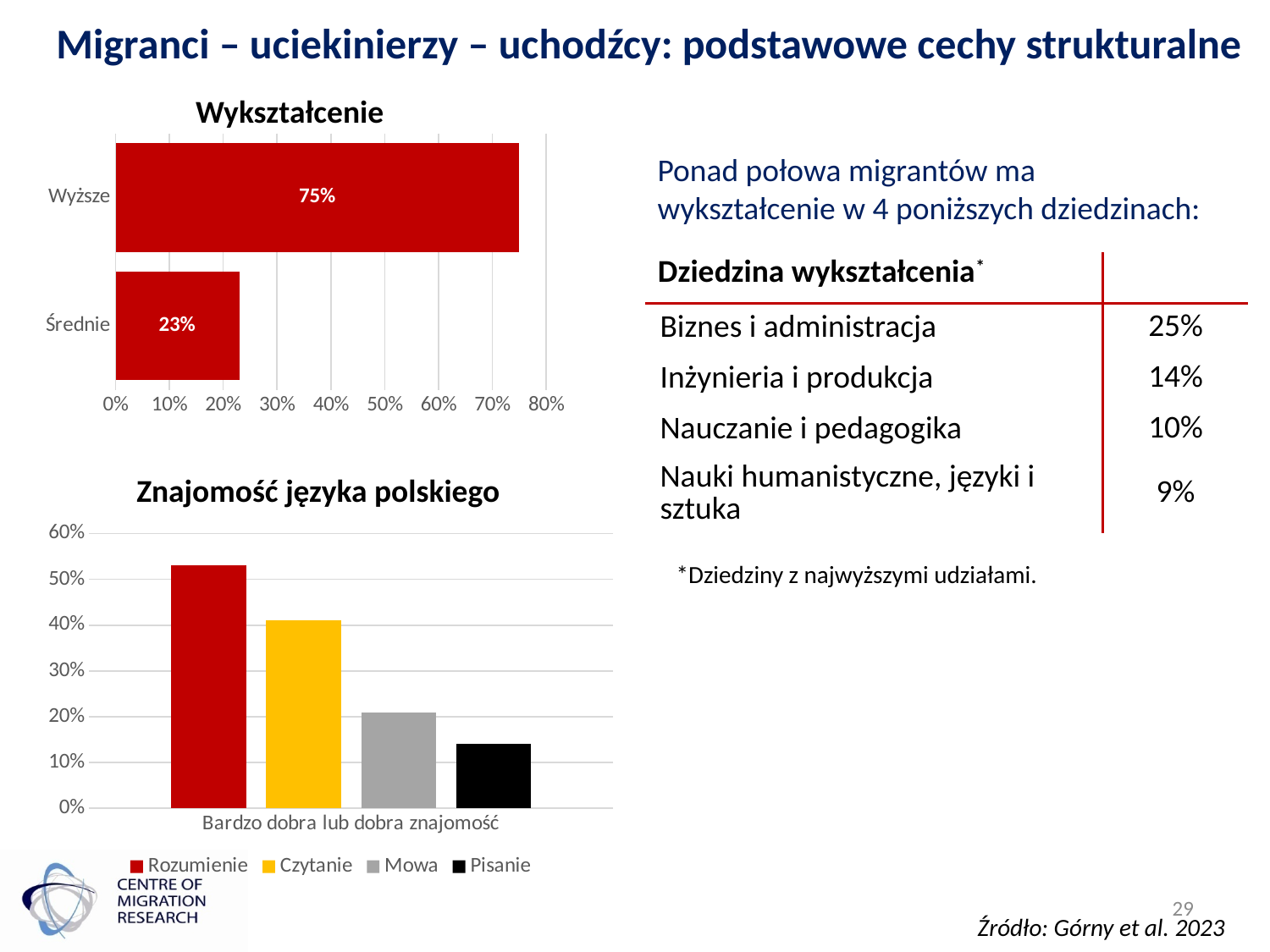
In the 'Znajomość języka polskiego' chart, which series is shown in yellow? Czytanie What kind of chart is the 'Wykształcenie' chart? Bar chart In the 'Znajomość języka polskiego' chart, is the value for Pisanie greater or less than 20%? less In the 'Wykształcenie' chart, what is the difference between the values for Wyższe and Średnie? 52% In the 'Znajomość języka polskiego' chart, which series has the lowest value? Pisanie How many categories are shown in the 'Wykształcenie' chart? 2 In the 'Znajomość języka polskiego' chart, which series has the highest value? Rozumienie In the 'Znajomość języka polskiego' chart, how many series does the legend list? 4 In the 'Wykształcenie' chart, which category has the higher value, Wyższe or Średnie? Wyższe In the 'Wykształcenie' chart, what is the value for Średnie? 23% In the 'Wykształcenie' chart, what is the value for Wyższe? 75% In the 'Znajomość języka polskiego' chart, is the value for Rozumienie greater or less than 50%? greater